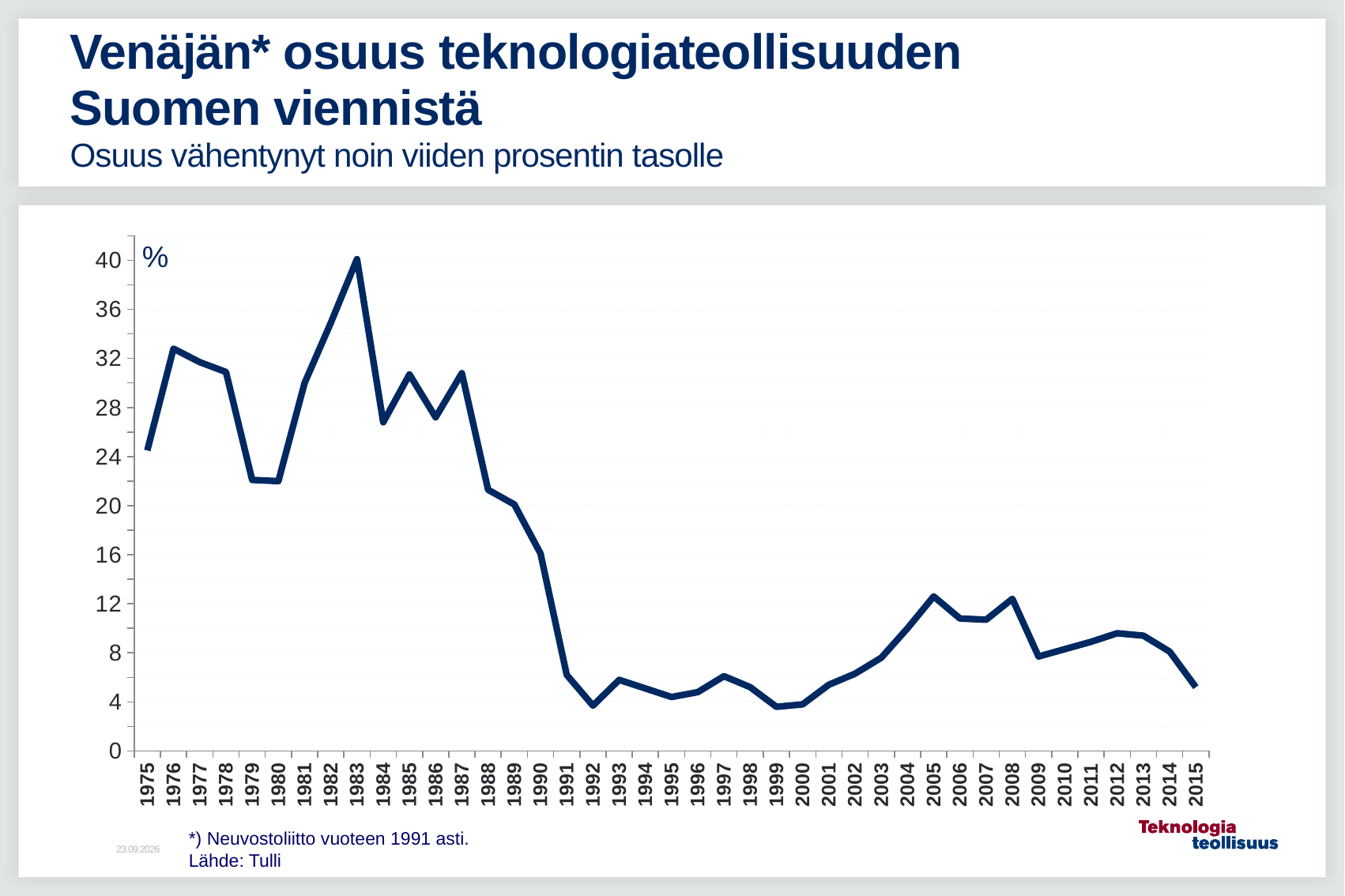
Is the value for 1983 greater or less than 36? greater What unit is shown at the top of the y axis? % Which year has the highest value on the chart? 1983 What kind of chart is shown on the slide? line chart Which year has the larger value, 1976 or 1979? 1976 Is the value for 1979 greater or less than 20? greater Is the value for 2015 greater or less than 8? less Which year has the larger value, 1985 or 1984? 1985 Overall, does the value rise or fall from 1975 to 2015? fall How many years are shown on the x axis? 41